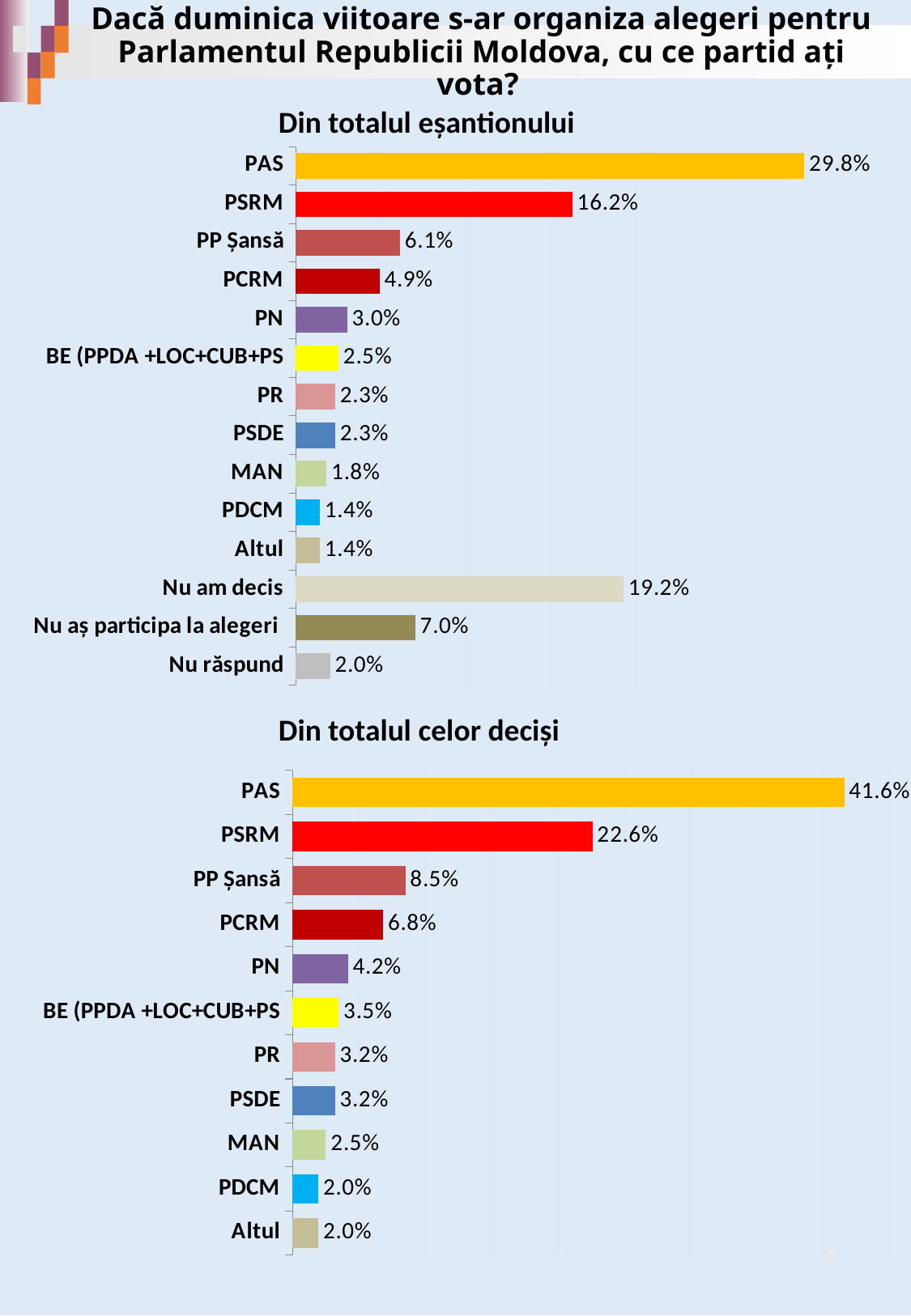
In the 'Din totalul eșantionului' chart, what is the difference between PSRM and Nu am decis? 3.0% In the 'Din totalul eșantionului' chart, which category has the lowest value? PDCM and Altul (1.4%) What type of chart is 'Din totalul celor deciși'? Bar chart In the 'Din totalul celor deciși' chart, what is the difference between PAS and PSRM? 19.0% In the 'Din totalul celor deciși' chart, what is the value for PCRM? 6.8% How many categories are shown in the 'Din totalul celor deciși' chart? 11 How many categories are shown in the 'Din totalul eșantionului' chart? 14 In the 'Din totalul eșantionului' chart, what is the value for Nu am decis? 19.2% In the 'Din totalul celor deciși' chart, which category has the highest value? PAS In the 'Din totalul eșantionului' chart, which is larger, PP Șansă or Nu aș participa la alegeri? Nu aș participa la alegeri In the 'Din totalul celor deciși' chart, what is the value for PSRM? 22.6% In the 'Din totalul eșantionului' chart, what is the value for PAS? 29.8%